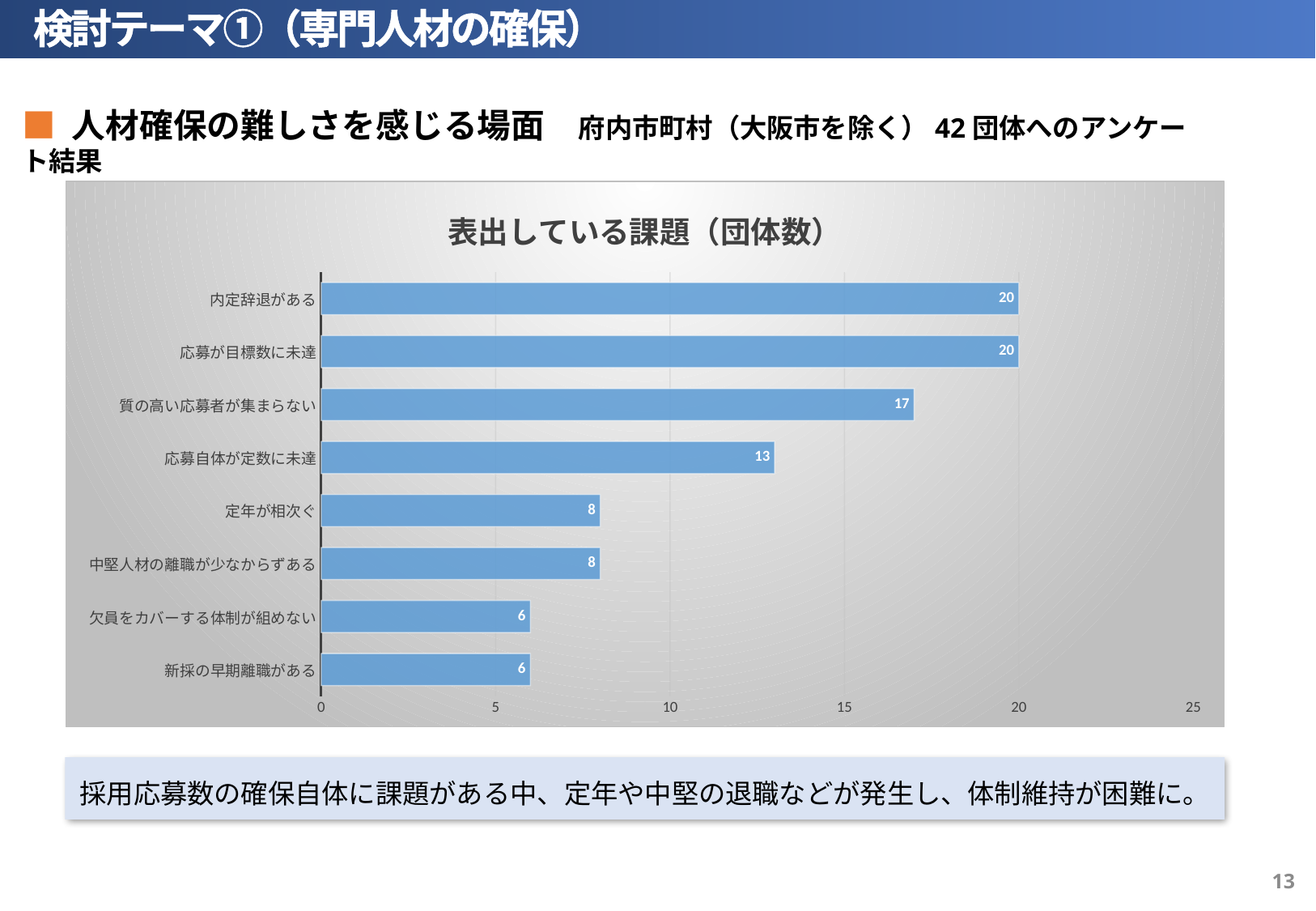
What is the value for 応募自体が定数に未達? 13 How many categories are shown in the chart? 8 What is the title of the chart? 表出している課題（団体数） What is the value for 質の高い応募者が集まらない? 17 What kind of chart is shown on the slide? bar chart What is the value for 定年が相次ぐ? 8 Which categories have the lowest value? 欠員をカバーする体制が組めない and 新採の早期離職がある Which categories have the highest value? 内定辞退がある and 応募が目標数に未達 What is the difference between the values for 内定辞退がある and 応募自体が定数に未達? 7 What is the value for 欠員をカバーする体制が組めない? 6 Is the value for 応募自体が定数に未達 greater or less than 10? greater Which is larger, the value for 質の高い応募者が集まらない or the value for 中堅人材の離職が少なからずある? 質の高い応募者が集まらない